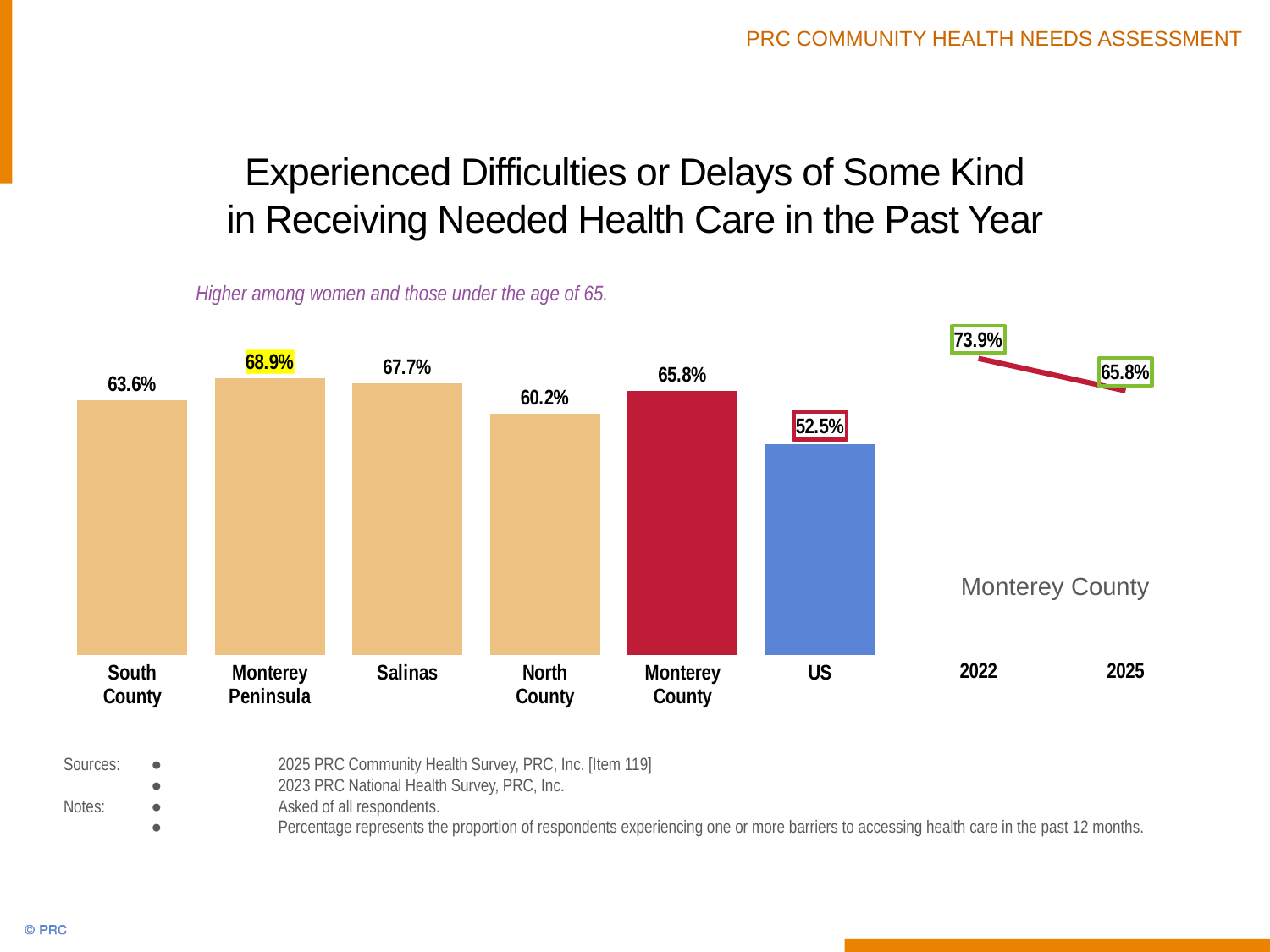
In the bar chart, which is larger, South County or Salinas? Salinas In the bar chart, what is the difference between Monterey County and the US? 13.3 percentage points In the bar chart, which category has the highest value? Monterey Peninsula In the bar chart, what is the value for the US? 52.5% In the bar chart, which category has the lowest value? US In the Monterey County trend chart on the right, what is the value for 2022? 73.9% How many categories does the bar chart show? 6 In the bar chart, what is the value for North County? 60.2% In the bar chart, what is the value for Monterey Peninsula? 68.9% What kind of chart is the chart on the left? Bar chart In the Monterey County trend chart on the right, does the value rise or fall from 2022 to 2025? Fall In the Monterey County trend chart on the right, what is the difference between the 2022 and 2025 values? 8.1 percentage points